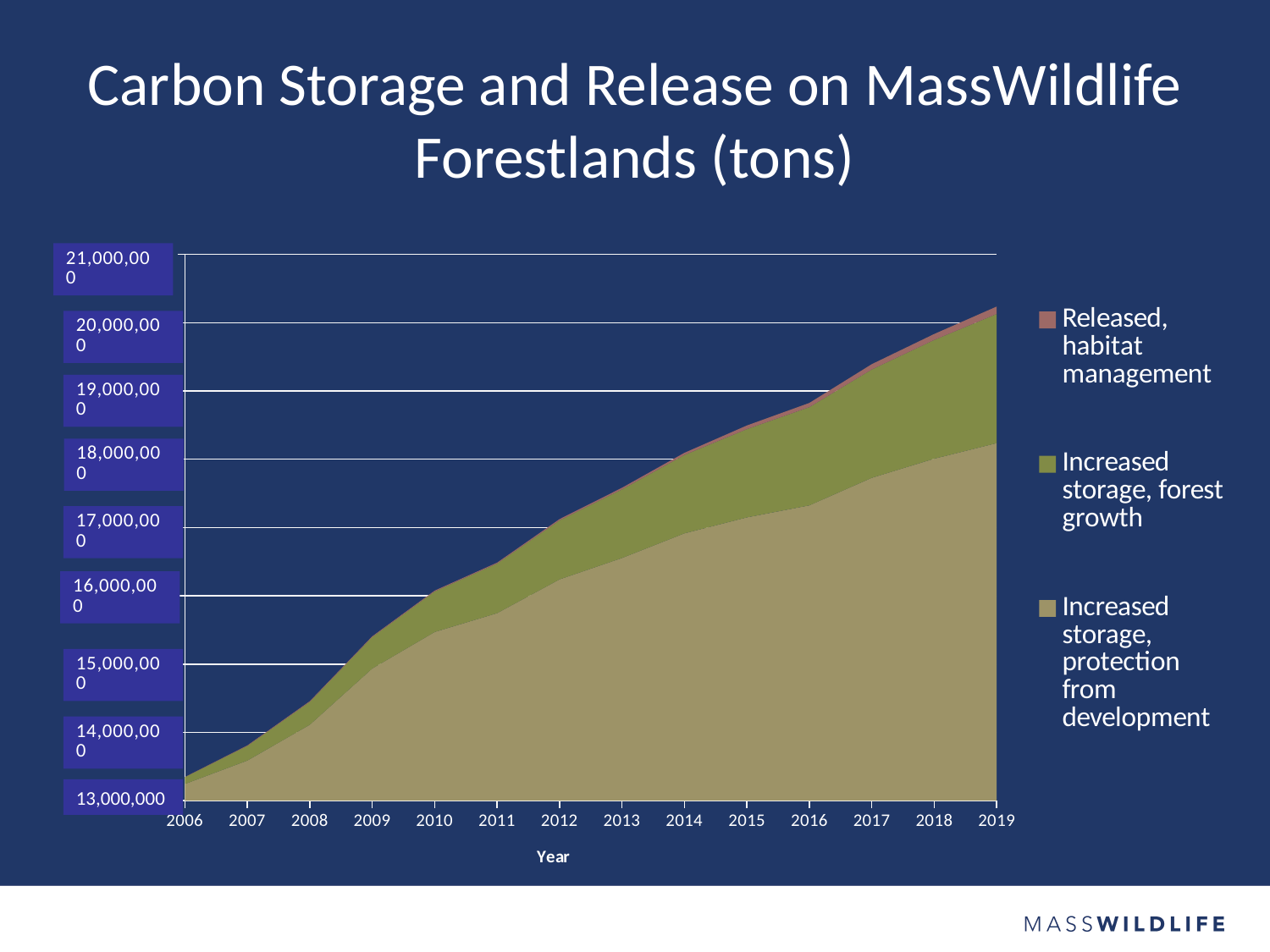
Is the top of the stacked area in 2019 greater or less than 20,000,000? greater How many series does the legend list? 3 What kind of chart is shown on the slide? Stacked area chart What is the title of the chart? Carbon Storage and Release on MassWildlife Forestlands (tons) Which series contributes the smallest area to the stack? Released, habitat management Is the top of the stacked area in 2008 greater or less than 15,000,000? less Do the stacked values rise or fall from 2006 to 2019? Rise Is the value for 'Increased storage, protection from development' in 2019 greater or less than 18,000,000? greater How many years are plotted along the x axis? 14 What is the label of the x axis? Year